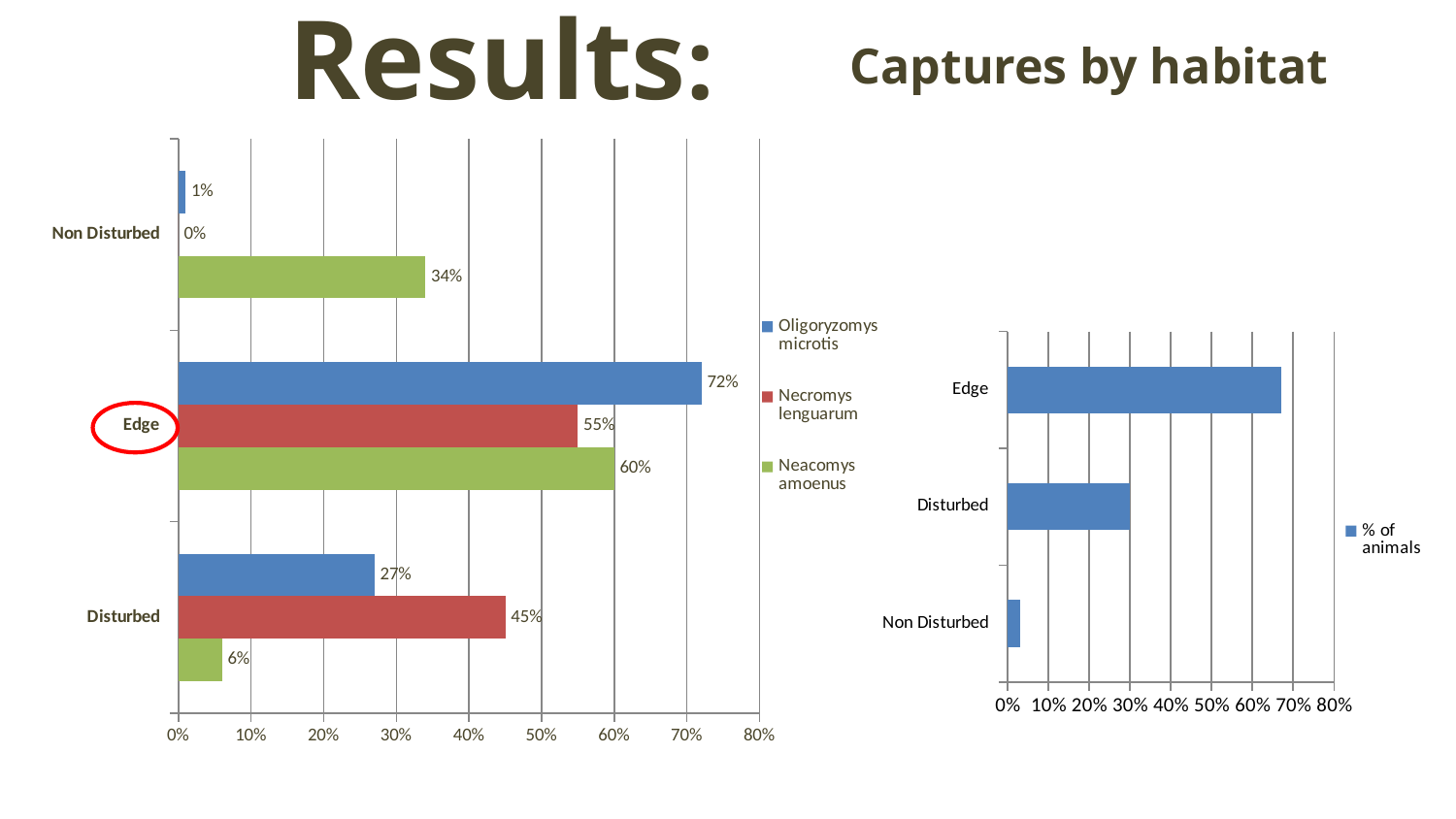
In the left chart, what is the difference between the Edge values for Oligoryzomys microtis and Necromys lenguarum? 17% In the left chart, which species has the highest value in the Edge habitat? Oligoryzomys microtis In the left chart, which is larger: Necromys lenguarum in Disturbed or Oligoryzomys microtis in Disturbed? Necromys lenguarum in Disturbed In the Captures by habitat chart, is the value for Non Disturbed greater or less than 10%? less In the left chart, what is the value for Oligoryzomys microtis in the Edge habitat? 72% In the Captures by habitat chart, which habitat has the highest % of animals? Edge In the left chart, what is the value for Neacomys amoenus in the Non Disturbed habitat? 34% In the left chart, which species has the lowest value in the Disturbed habitat? Neacomys amoenus How many series does the legend of the left chart list? 3 In the left chart, what is the value for Necromys lenguarum in the Disturbed habitat? 45% What kind of chart is the Captures by habitat chart? bar chart In the Captures by habitat chart, is the value for Edge greater or less than 60%? greater